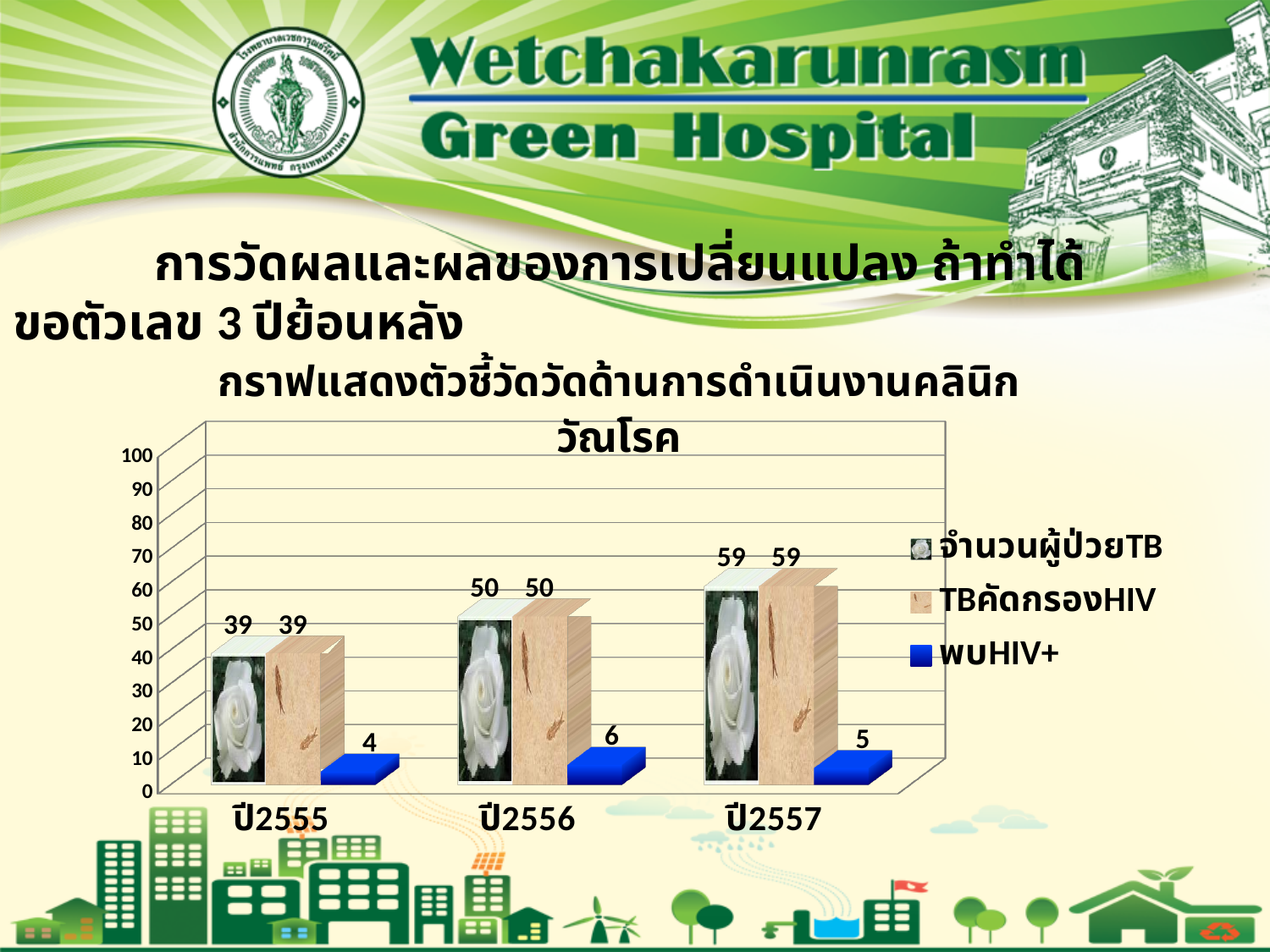
Which is larger: พบHIV+ in ปี2556 or in ปี2557? ปี2556 What is the value of พบHIV+ for ปี2556? 6 Is the value for TBคัดกรองHIV in ปี2556 greater or less than 40? greater What is the difference between จำนวนผู้ป่วยTB in ปี2557 and in ปี2555? 20 Which year has the lowest value for พบHIV+? ปี2555 Which year has the highest value for จำนวนผู้ป่วยTB? ปี2557 How many years are shown on the x axis? 3 How many series does the legend list? 3 What is the value of จำนวนผู้ป่วยTB for ปี2555? 39 What kind of chart is shown on the slide? bar chart Does the value for จำนวนผู้ป่วยTB rise or fall from ปี2555 to ปี2557? rise What is the value of TBคัดกรองHIV for ปี2557? 59